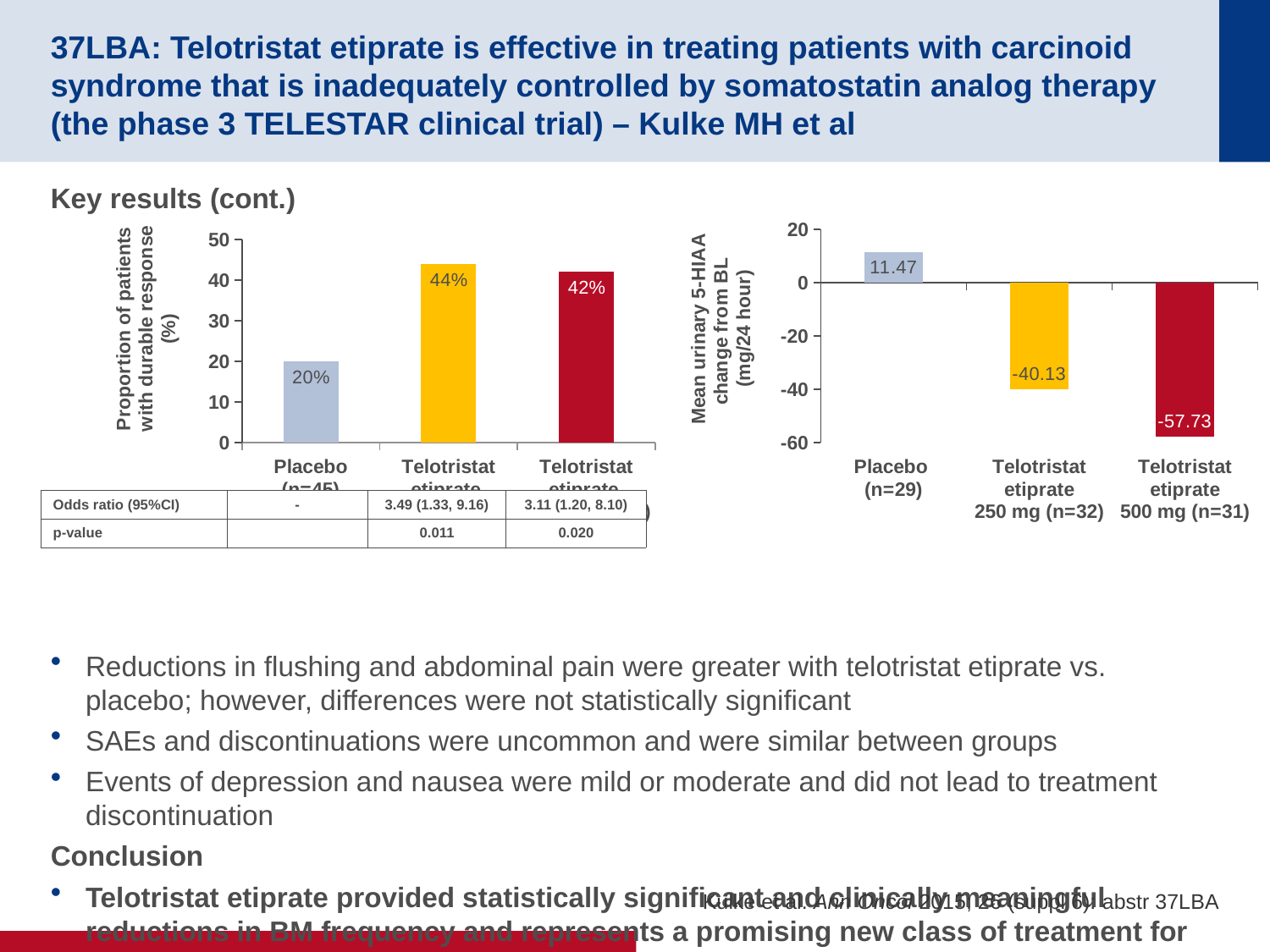
In the right chart (mean urinary 5-HIAA change from BL), what is the value for Placebo (n=29)? 11.47 In the left chart (proportion of patients with durable response), what is the difference between the middle bar (44%) and the Placebo bar? 24% In the right chart (mean urinary 5-HIAA change from BL), which category has the lowest value? Telotristat etiprate 500 mg (n=31) In the right chart (mean urinary 5-HIAA change from BL), what is the value for Telotristat etiprate 250 mg (n=32)? -40.13 In the left chart (proportion of patients with durable response), how many bars are plotted? 3 In the right chart (mean urinary 5-HIAA change from BL), what is the value for Telotristat etiprate 500 mg (n=31)? -57.73 In the right chart (mean urinary 5-HIAA change from BL), is the value for Telotristat etiprate 250 mg (n=32) greater or less than -20? less In the left chart (proportion of patients with durable response), what is the value shown on the middle (yellow) bar? 44% In the left chart (proportion of patients with durable response), what is the value for Placebo? 20% In the left chart (proportion of patients with durable response), what is the value shown on the rightmost (red) bar? 42% In the left chart (proportion of patients with durable response), which category has the lowest value? Placebo What kind of chart is the right chart (mean urinary 5-HIAA change from BL)? Bar chart